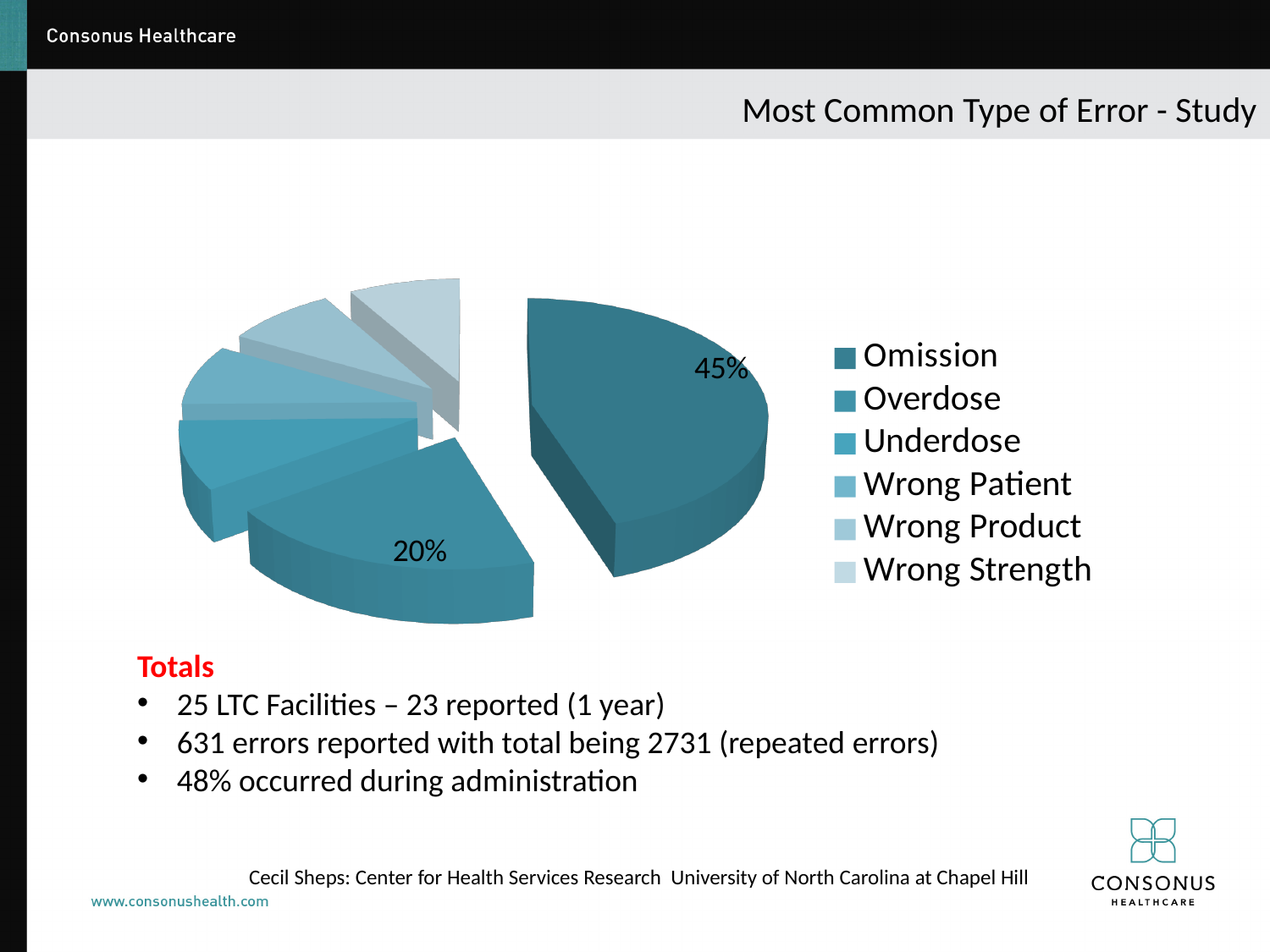
Which legend entry is listed last? Wrong Strength By how many percentage points does Omission exceed Overdose? 25 percentage points What percentage is shown for the Overdose slice? 20% How many entries does the legend list? 6 How many error types are shown in the pie chart? 6 What percentage of errors does the Omission slice represent? 45% What share of the pie does the Omission slice take? 45% Which slice is larger, Omission or Overdose? Omission What kind of chart is shown on the slide? Pie chart Which type of error has the largest slice of the pie? Omission What is the title of the slide containing the chart? Most Common Type of Error - Study Which slice is larger, Overdose or Wrong Strength? Overdose